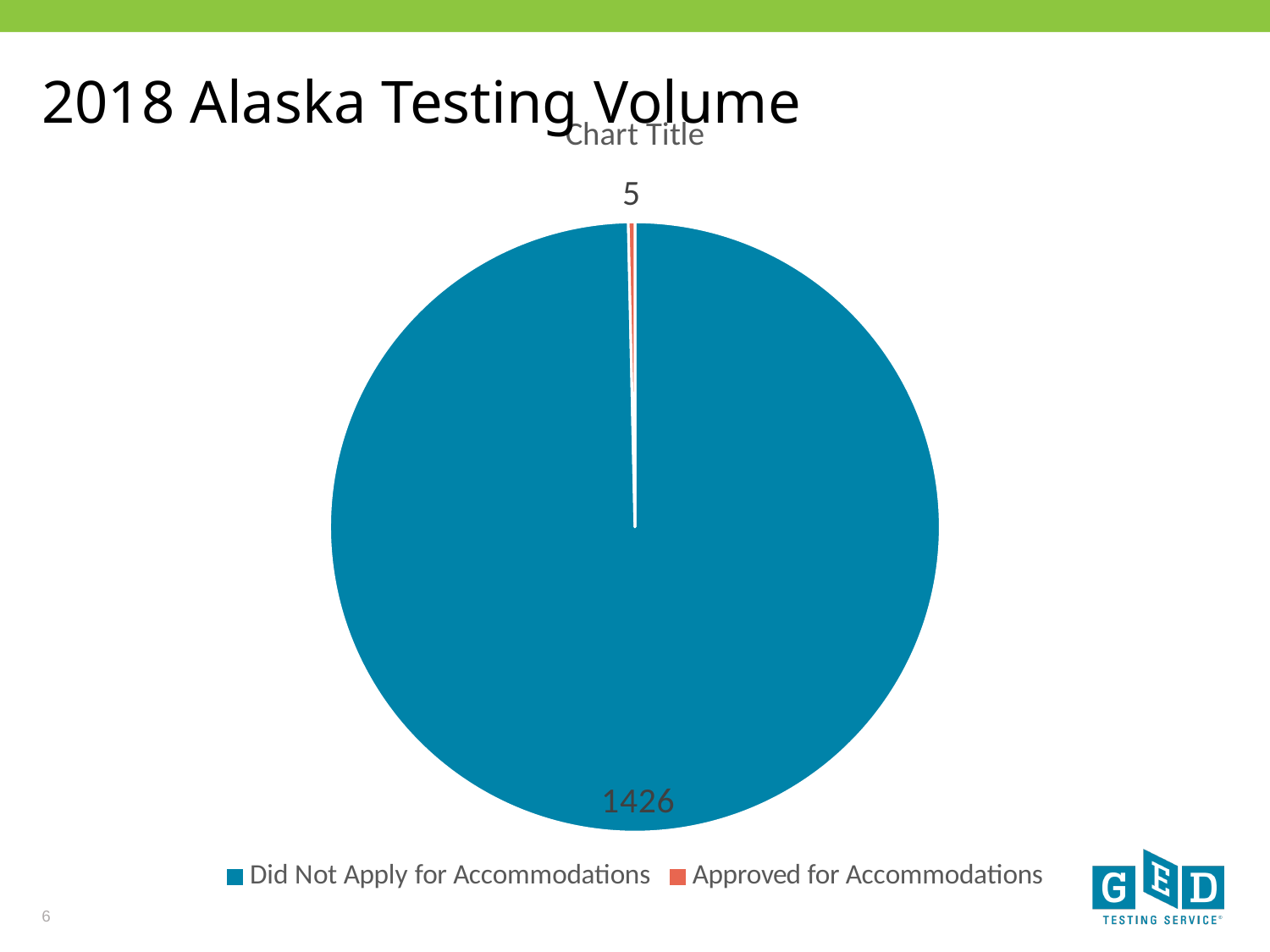
What is the title of the slide? 2018 Alaska Testing Volume Which category has the smallest slice of the pie? Approved for Accommodations What is the total of the two values shown on the pie chart? 1431 Which category has the largest slice of the pie? Did Not Apply for Accommodations Which is larger, Did Not Apply for Accommodations or Approved for Accommodations? Did Not Apply for Accommodations What kind of chart is shown on the slide? pie chart What is the value for Did Not Apply for Accommodations? 1426 How many categories does the pie chart show? 2 What is the difference between the Did Not Apply for Accommodations value and the Approved for Accommodations value? 1421 What is the value for Approved for Accommodations? 5 What colour is the Approved for Accommodations slice? orange